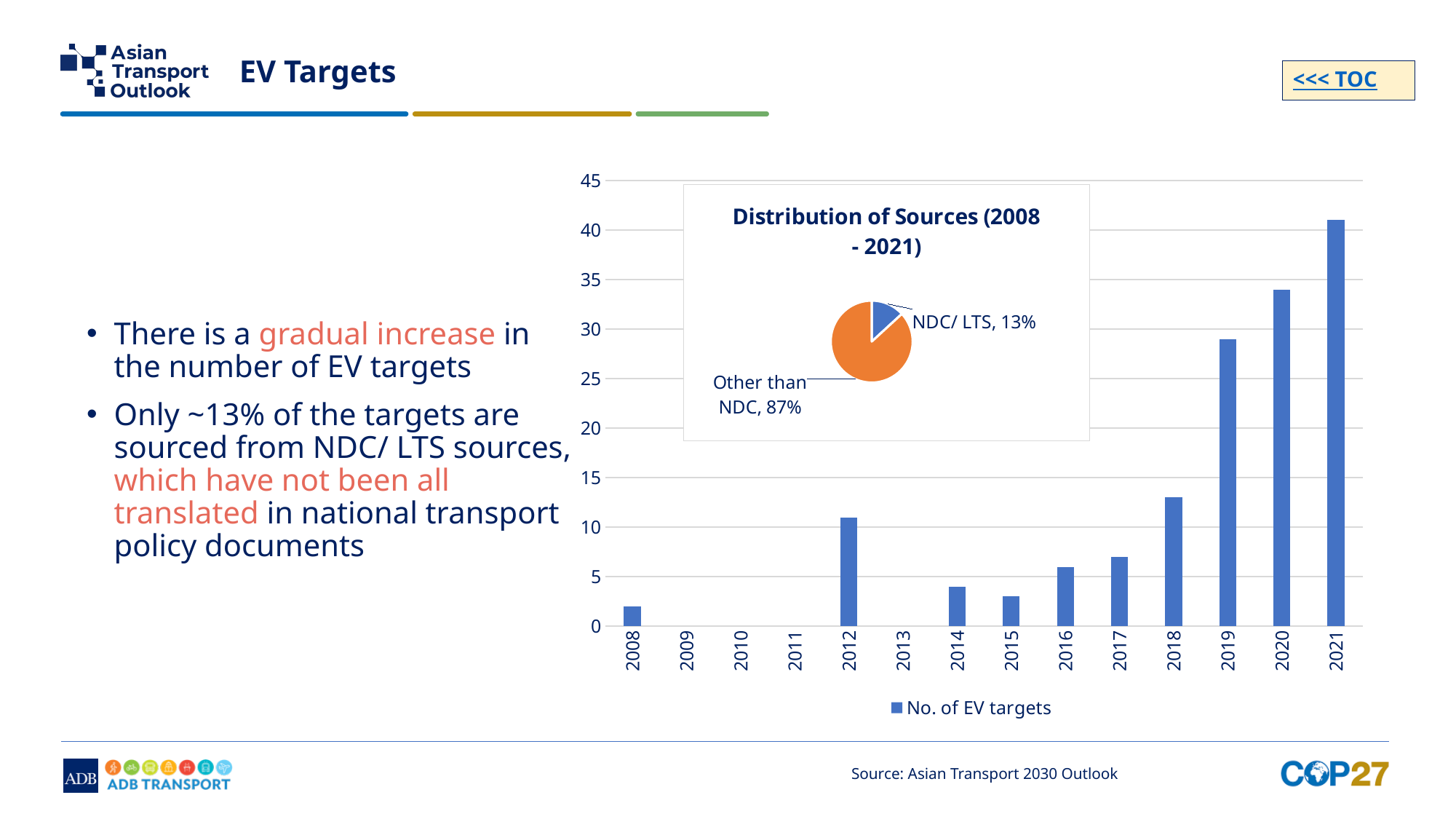
In the bar chart, is the value for 2008 greater or less than 5? less In the pie chart 'Distribution of Sources (2008 - 2021)', what share of sources is Other than NDC? 87% In the bar chart, is the value for 2018 greater or less than 10? greater In the bar chart, what is the legend entry for the series? No. of EV targets In the pie chart 'Distribution of Sources (2008 - 2021)', what share of sources is NDC/ LTS? 13% In the bar chart, what kind of chart shows the number of EV targets by year? bar chart In the bar chart, which year has the highest number of EV targets? 2021 In the bar chart, how many years are shown on the x axis? 14 In the bar chart, is the value for 2021 greater or less than 40? greater In the bar chart, do the number of EV targets generally rise or fall from 2014 to 2021? rise In the bar chart, which year has the larger number of EV targets, 2019 or 2020? 2020